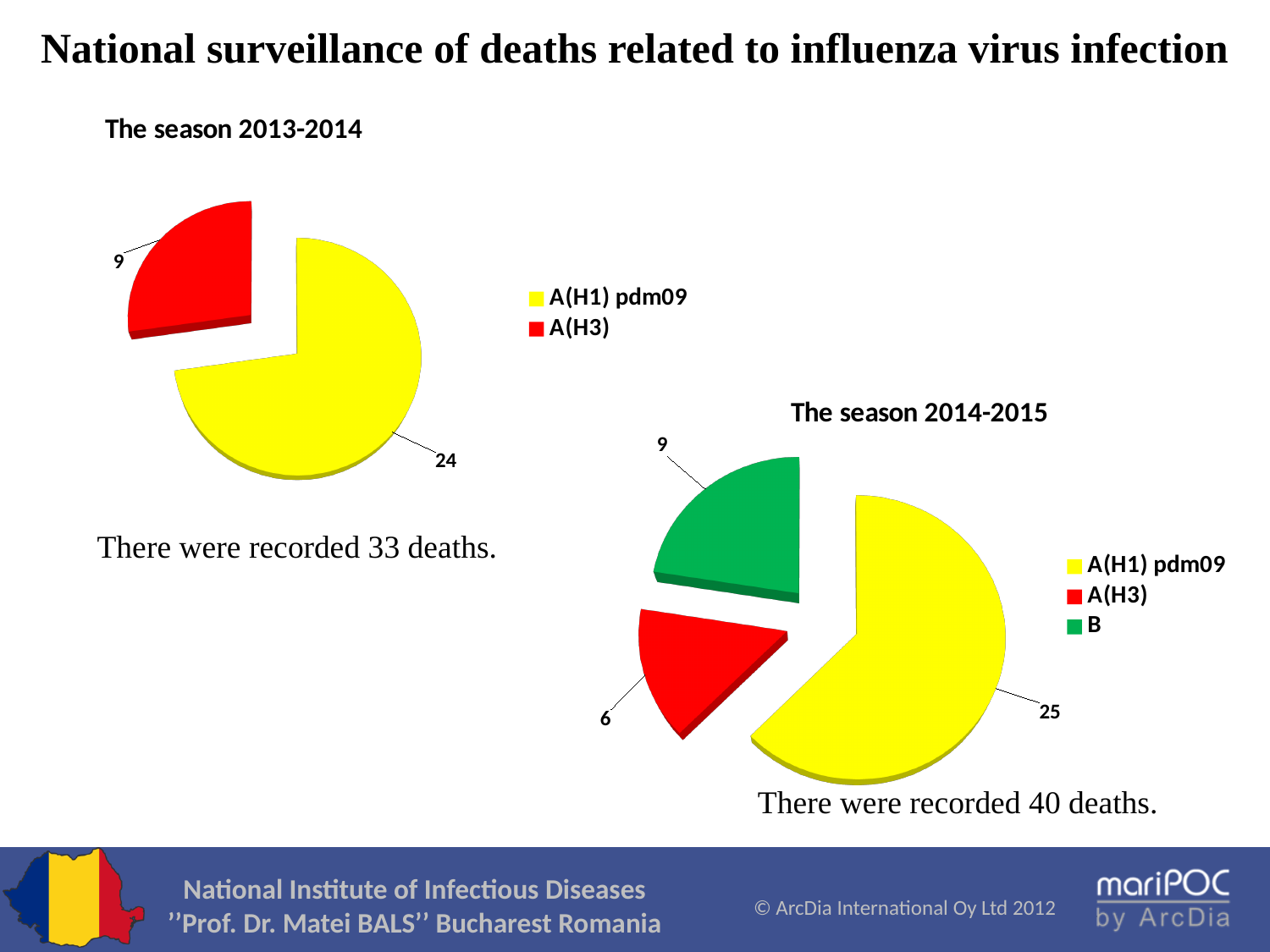
In the pie chart for the season 2013-2014, how many deaths are attributed to A(H3)? 9 In the pie chart for the season 2014-2015, which virus type has the smallest slice? A(H3) In the pie chart for the season 2013-2014, how many deaths are attributed to A(H1) pdm09? 24 How many entries does the legend of the pie chart for the season 2013-2014 list? 2 How many slices does the pie chart for the season 2014-2015 have? 3 In the pie chart for the season 2013-2014, what is the difference between the A(H1) pdm09 and A(H3) values? 15 In the pie chart for the season 2014-2015, how many deaths are attributed to B? 9 In the pie chart for the season 2014-2015, how many deaths are attributed to A(H3)? 6 In the pie chart for the season 2014-2015, what share of the total do the A(H3) deaths represent? 15% What colour represents B in the pie chart for the season 2014-2015? Green In the pie chart for the season 2014-2015, which virus type has the largest slice? A(H1) pdm09 In the pie chart for the season 2014-2015, what is the difference between the B and A(H3) values? 3